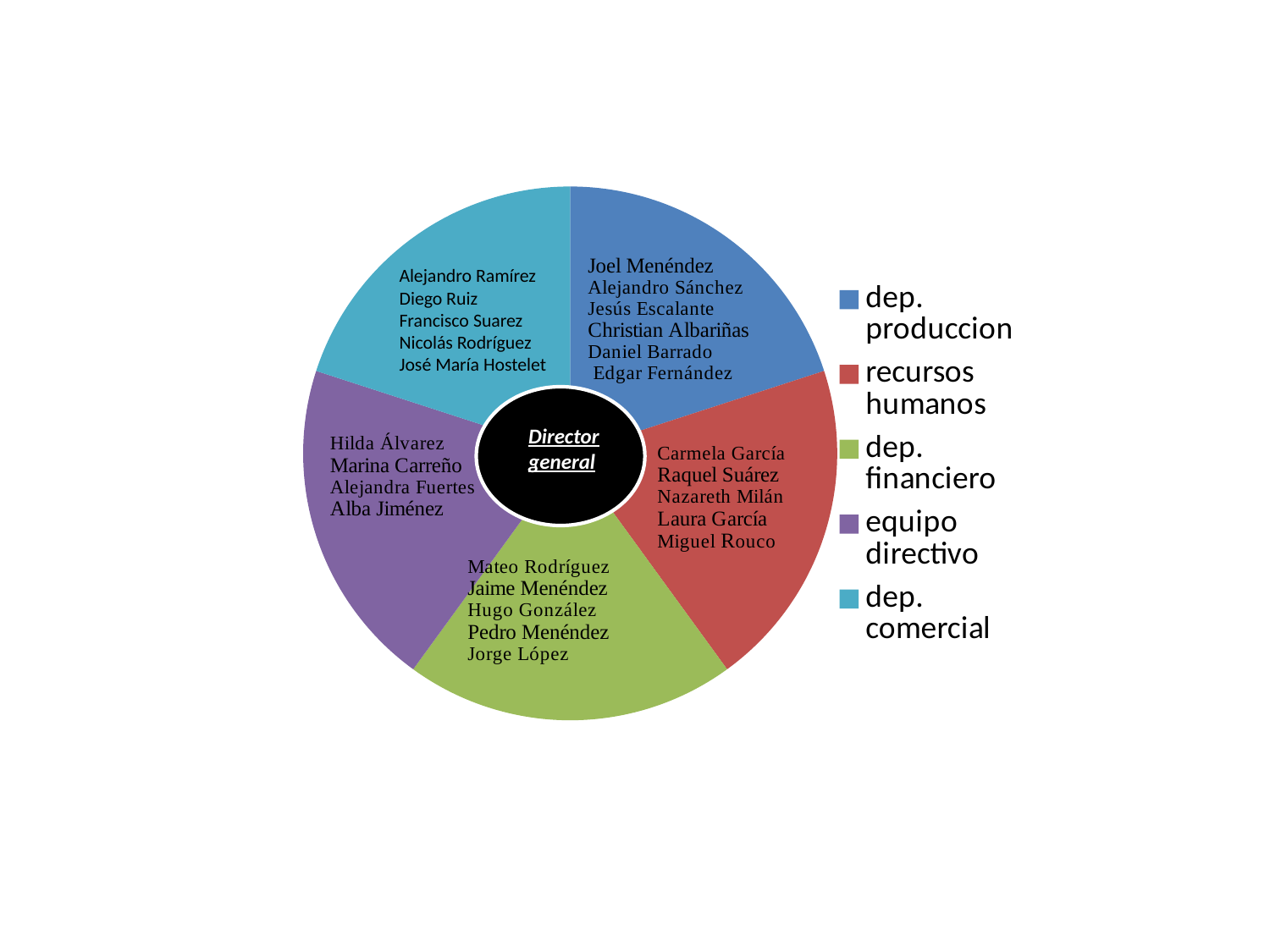
What kind of chart is shown on the slide? pie chart How many names are listed in the equipo directivo slice? 4 How many slices does the pie chart have? 5 Which slice of the pie chart lists Jorge López? dep. financiero How many entries does the legend of the pie chart list? 5 Which slice of the pie chart lists Hilda Álvarez? equipo directivo How many names are listed in the dep. comercial slice? 5 What text appears in the centre of the pie chart? Director general Which slice of the pie chart lists Carmela García? recursos humanos Which legend entry is shown in blue? dep. produccion Which slice of the pie chart lists Diego Ruiz? dep. comercial